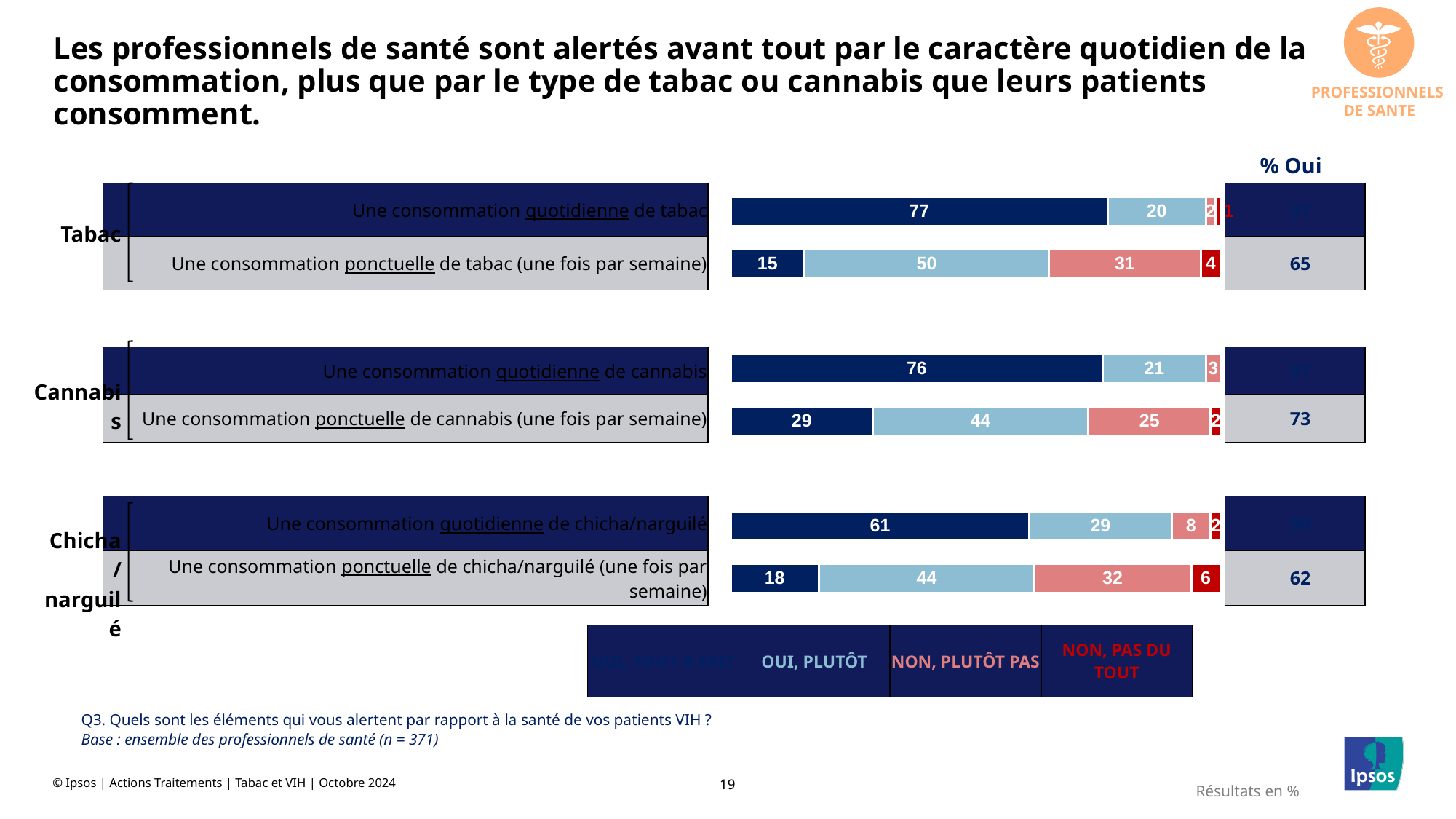
Which is larger: the "NON, PAS DU TOUT" value for ponctuelle chicha/narguilé or for ponctuelle tabac? Ponctuelle chicha/narguilé Which category has the lowest value in the first (dark blue) segment of the bars? Une consommation ponctuelle de tabac (une fois par semaine) What is the "% Oui" value shown for "Une consommation ponctuelle de chicha/narguilé (une fois par semaine)"? 62 What is the heading of the column to the right of the bars? % Oui How many categories (bars) are plotted on the chart? 6 Which category has the highest value in the first (dark blue) segment of the bars? Une consommation quotidienne de tabac What is the difference between the first-segment values for "Une consommation quotidienne de cannabis" and "Une consommation ponctuelle de cannabis (une fois par semaine)"? 47 What is the "OUI, PLUTÔT" value for "Une consommation ponctuelle de tabac (une fois par semaine)"? 50 What is the "% Oui" value shown for "Une consommation ponctuelle de cannabis (une fois par semaine)"? 73 What kind of chart is shown on the slide? Stacked bar chart What is the "NON, PLUTÔT PAS" value for "Une consommation ponctuelle de chicha/narguilé (une fois par semaine)"? 32 What is the total of the "OUI, PLUTÔT" and "NON, PLUTÔT PAS" segments for "Une consommation ponctuelle de cannabis (une fois par semaine)"? 69